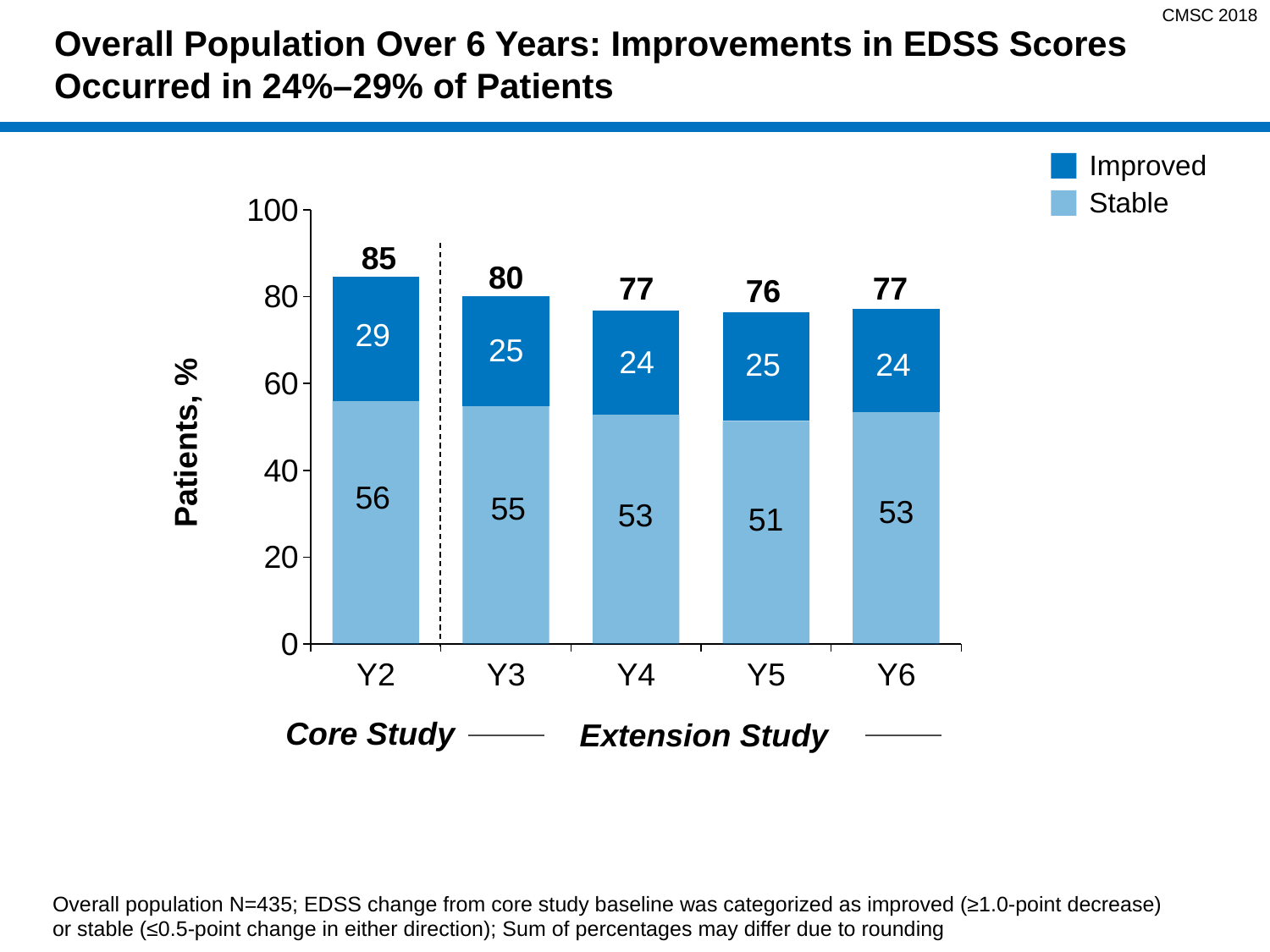
What is the total labelled above the Y3 bar? 80 What is the Stable value for Y5? 51 What is the Improved value for Y2? 29 Is the Stable value larger for Y3 or Y6? Y3 What is the label on the y axis? Patients, % Which year has the lowest total bar value? Y5 How many years are shown on the x axis? 5 Is the total for Y2 greater or less than 80? greater What kind of chart is shown? Stacked bar chart Which year has the highest Stable value? Y2 How many series does the legend list? 2 What is the difference between the Improved values for Y2 and Y4? 5